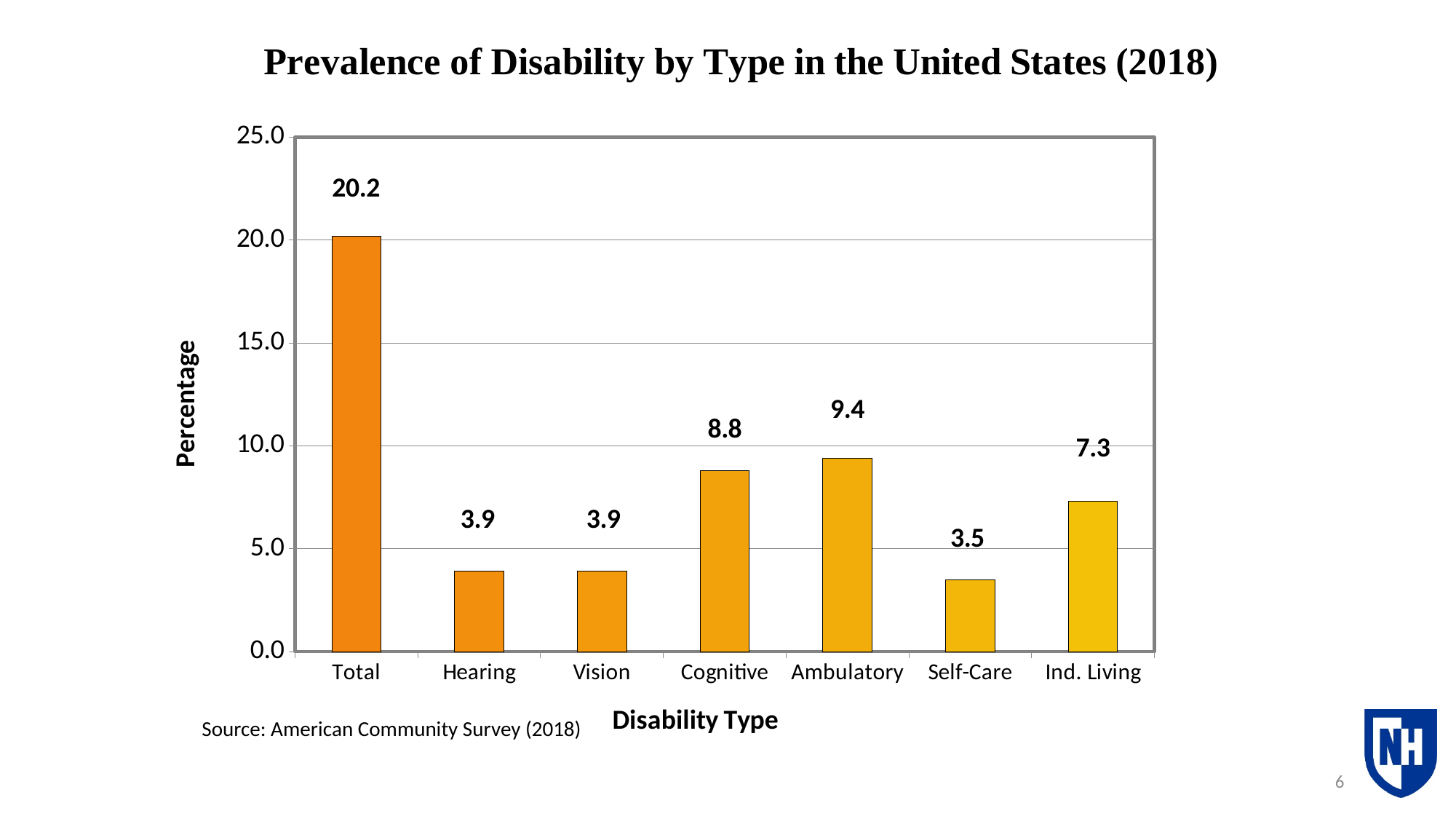
Which category has the highest value? Total What is the difference between the values for Total and Ind. Living? 12.9 What is the difference between the values for Ambulatory and Cognitive? 0.6 Is the value for Self-Care greater or less than 5.0? less What is the value for Total? 20.2 Which is larger, the value for Cognitive or the value for Ind. Living? Cognitive What is the value for Ind. Living? 7.3 What is the value for Ambulatory? 9.4 What kind of chart is shown on the slide? bar chart How many disability type categories are shown on the x axis? 7 What is the label of the y axis? Percentage Which disability type has the lowest value? Self-Care